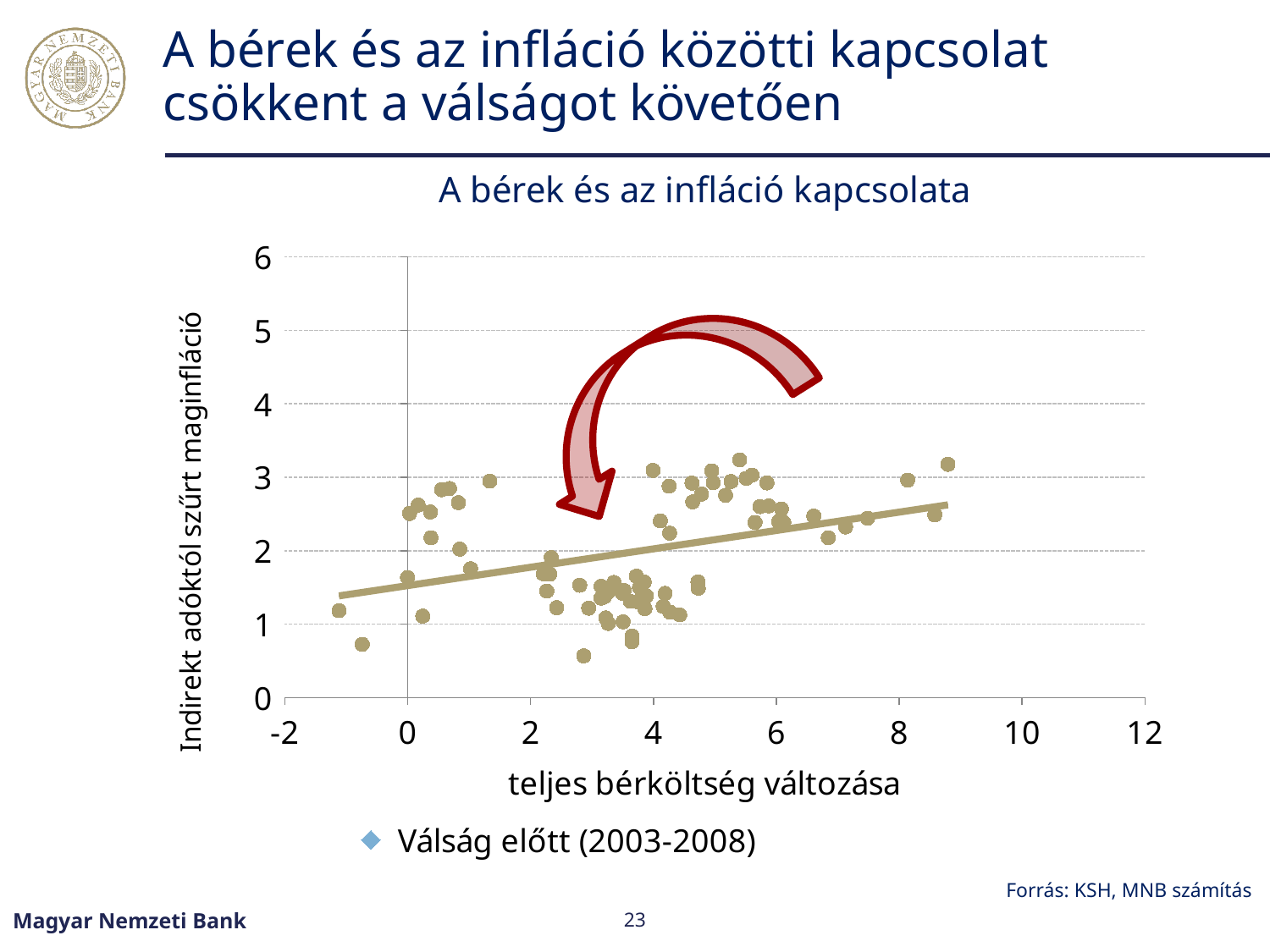
Is the highest plotted value of Indirekt adóktól szűrt maginfláció greater or less than 4? less What is the title of the chart? A bérek és az infláció kapcsolata Is the lowest plotted value of Indirekt adóktól szűrt maginfláció greater or less than 1? less Does the fitted trend line rise or fall as the x-axis value (teljes bérköltség változása) increases? rise What is the legend entry for the plotted series? Válság előtt (2003-2008) Is the largest plotted value of teljes bérköltség változása greater or less than 10? less How many series does the chart's legend list? 1 What kind of chart is shown on the slide? scatter chart